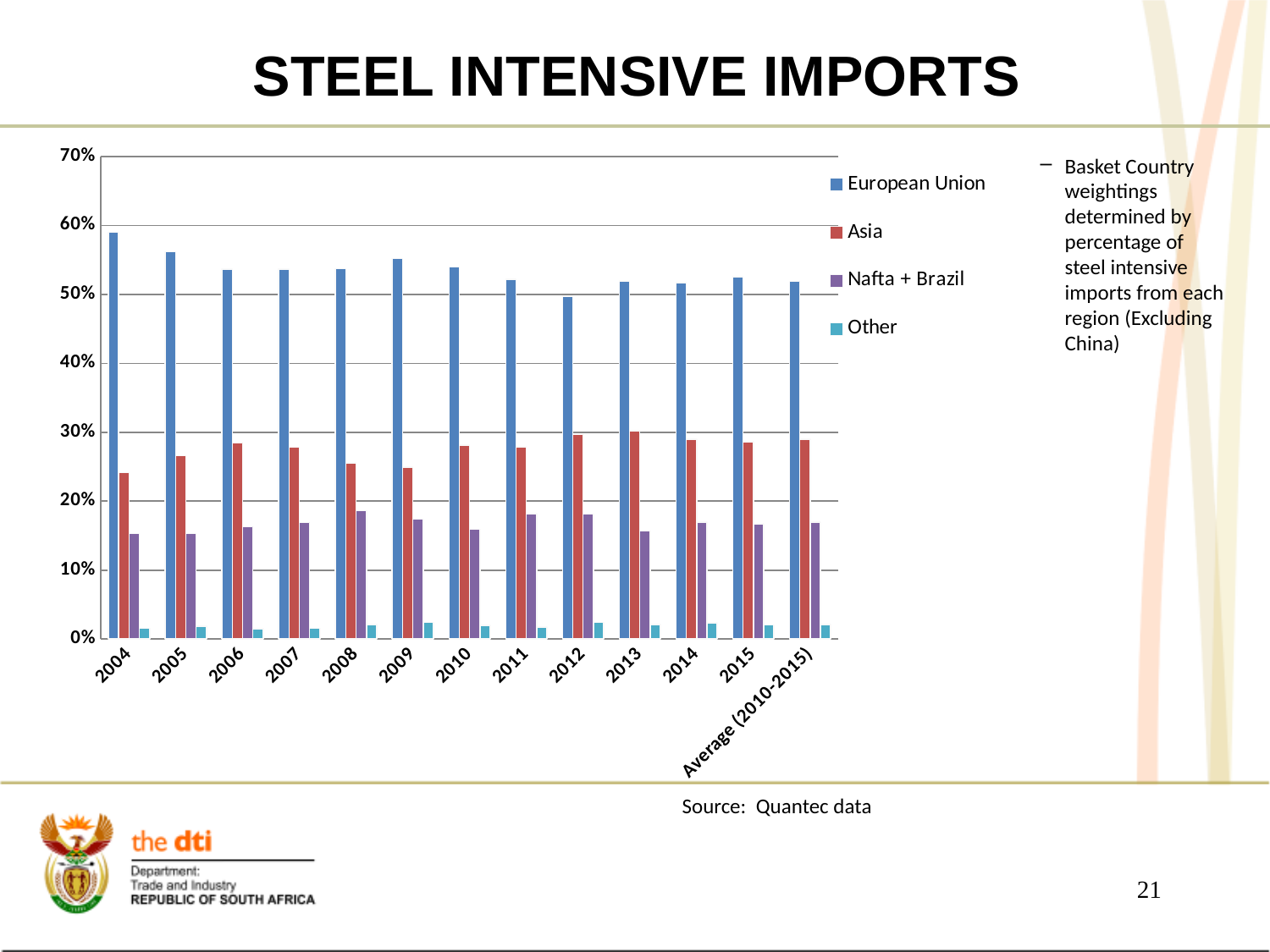
Which is larger in 2008, the value for Asia or the value for Nafta + Brazil? Asia How many series does the legend list? 4 What kind of chart is shown on the slide? bar chart How many categories are shown along the x axis? 13 Which series has the highest value in every year shown? European Union In which year is the European Union value highest? 2004 In which year is the Asia value lowest? 2004 Is the value for Nafta + Brazil in 2008 greater or less than 20%? less Does the European Union value generally rise or fall from 2004 to 2015? fall Is the value for European Union in 2004 greater or less than 50%? greater In which year is the European Union value lowest? 2012